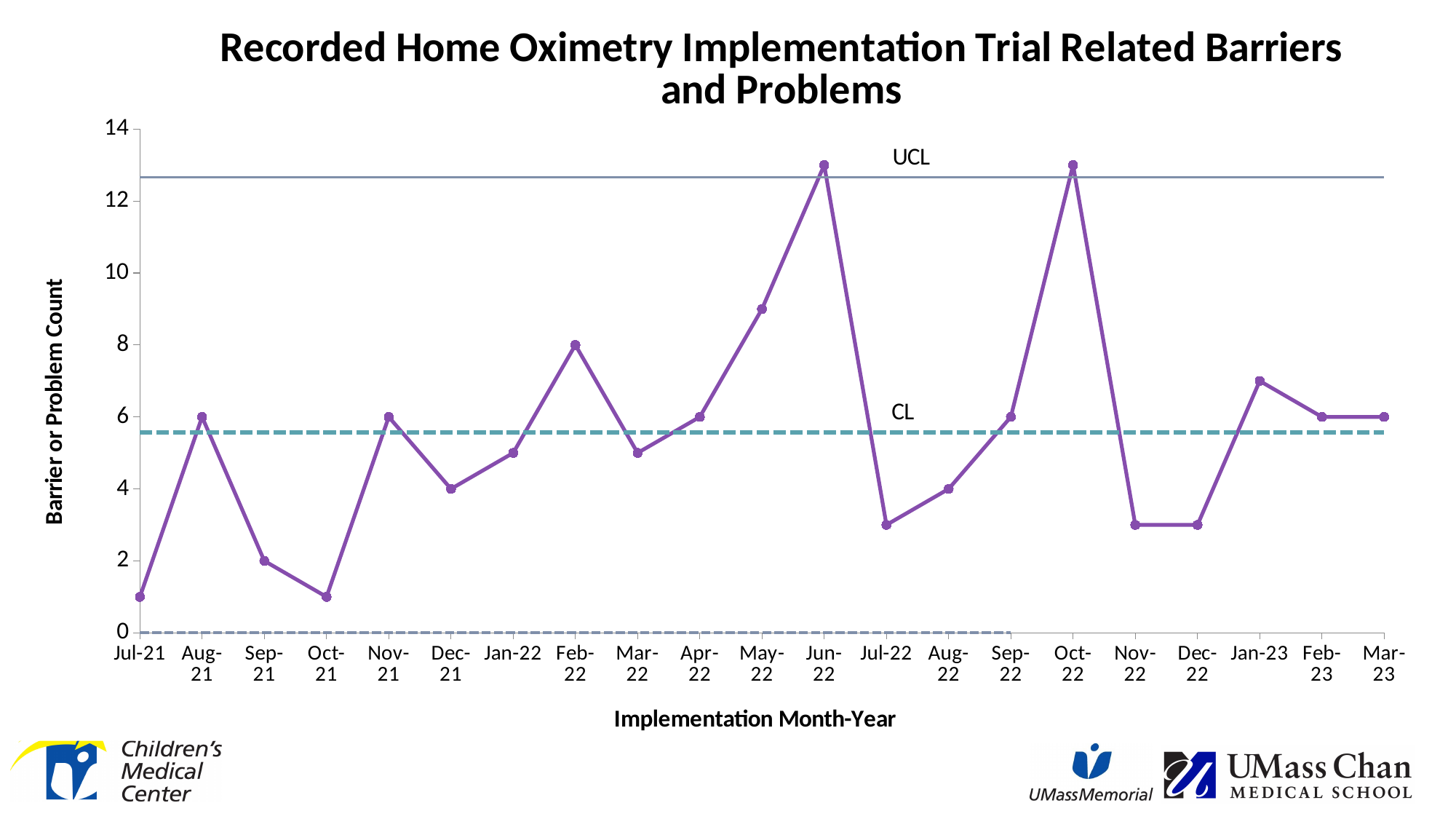
What is the Barrier or Problem Count for Dec-21? 4 Is the value for Nov-22 greater or less than 4? less What is the Barrier or Problem Count for Feb-22? 8 What type of chart is shown on the slide? Line chart What is the label of the y axis? Barrier or Problem Count Is the value for Jul-21 greater or less than 2? less What is the Barrier or Problem Count for Mar-23? 6 Is the value for Jun-22 greater or less than 12? greater Which month has the larger value, Feb-22 or Apr-22? Feb-22 How many monthly data points are plotted on the chart? 21 What is the Barrier or Problem Count for Sep-21? 2 What is the difference between the values for Feb-22 and Dec-21? 4